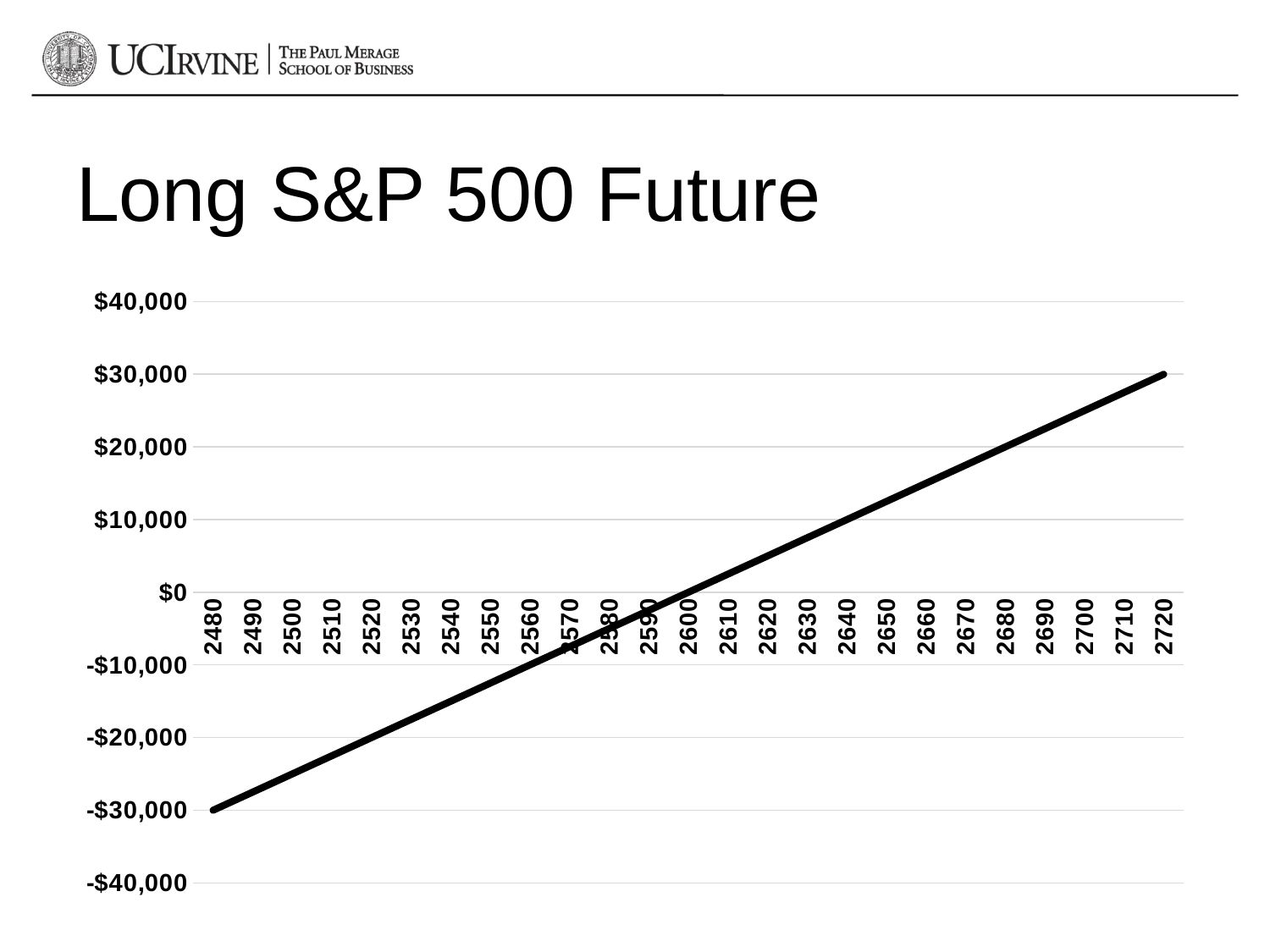
Which has the larger value, 2650 or 2550? 2650 What is the value of the line at an index level of 2480? -$30,000 At which x-axis value is the plotted value lowest? 2480 What kind of chart is shown on the slide? line chart At which index level on the x axis does the line cross $0? 2600 What is the value of the line at an index level of 2720? $30,000 What is the difference between the value at 2720 and the value at 2480? $60,000 Is the value at 2700 greater or less than $20,000? greater At which x-axis value is the plotted value highest? 2720 What is the title of the chart? Long S&P 500 Future Is the value at 2500 greater or less than -$20,000? less Do the values rise or fall as the index level increases along the x axis? rise